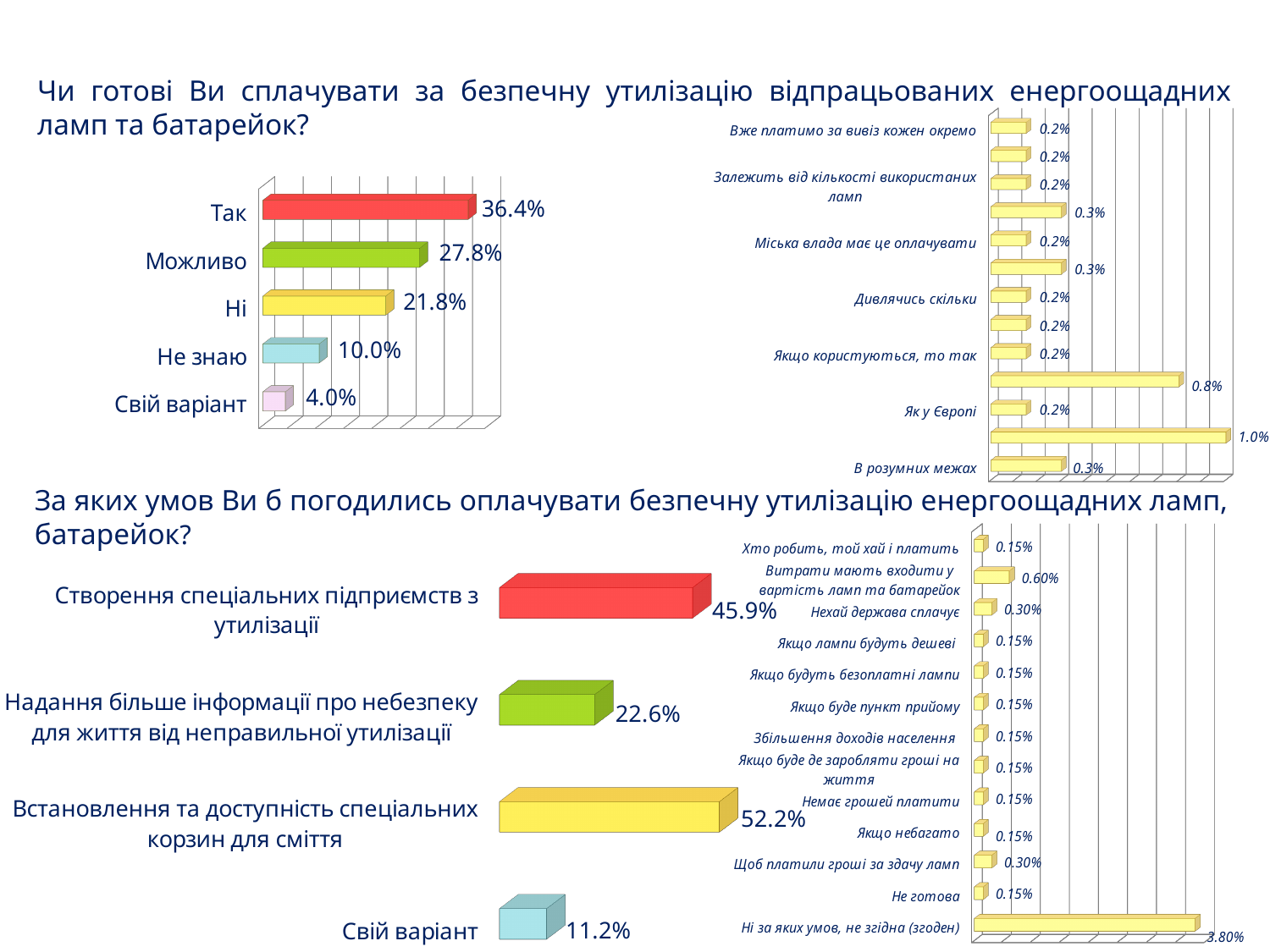
In the bottom-left chart (За яких умов Ви б погодились оплачувати...), what is the value for Надання більше інформації про небезпеку для життя від неправильної утилізації? 22.6% In the bottom-left chart, which is larger: Створення спеціальних підприємств з утилізації or Свій варіант? Створення спеціальних підприємств з утилізації In the top-left chart, which category has the lowest value? Свій варіант In the bottom-left chart, what is the difference between Встановлення та доступність спеціальних корзин для сміття and Створення спеціальних підприємств з утилізації? 6.3% In the bottom-right chart, what is the value for Витрати мають входити у вартість ламп та батарейок? 0.60% In the top-left chart, how many categories are shown? 5 In the bottom-right chart, what is the value for Ні за яких умов, не згідна (згоден)? 3.80% In the top-right chart, what is the value for В розумних межах? 0.3% In the top-left chart, what is the difference between Так and Можливо? 8.6% In the top-right chart, what is the value for Як у Європі? 0.2% In the top-left chart (Чи готові Ви сплачувати за безпечну утилізацію...), what is the value for Так? 36.4% In the bottom-left chart, which category has the highest value? Встановлення та доступність спеціальних корзин для сміття